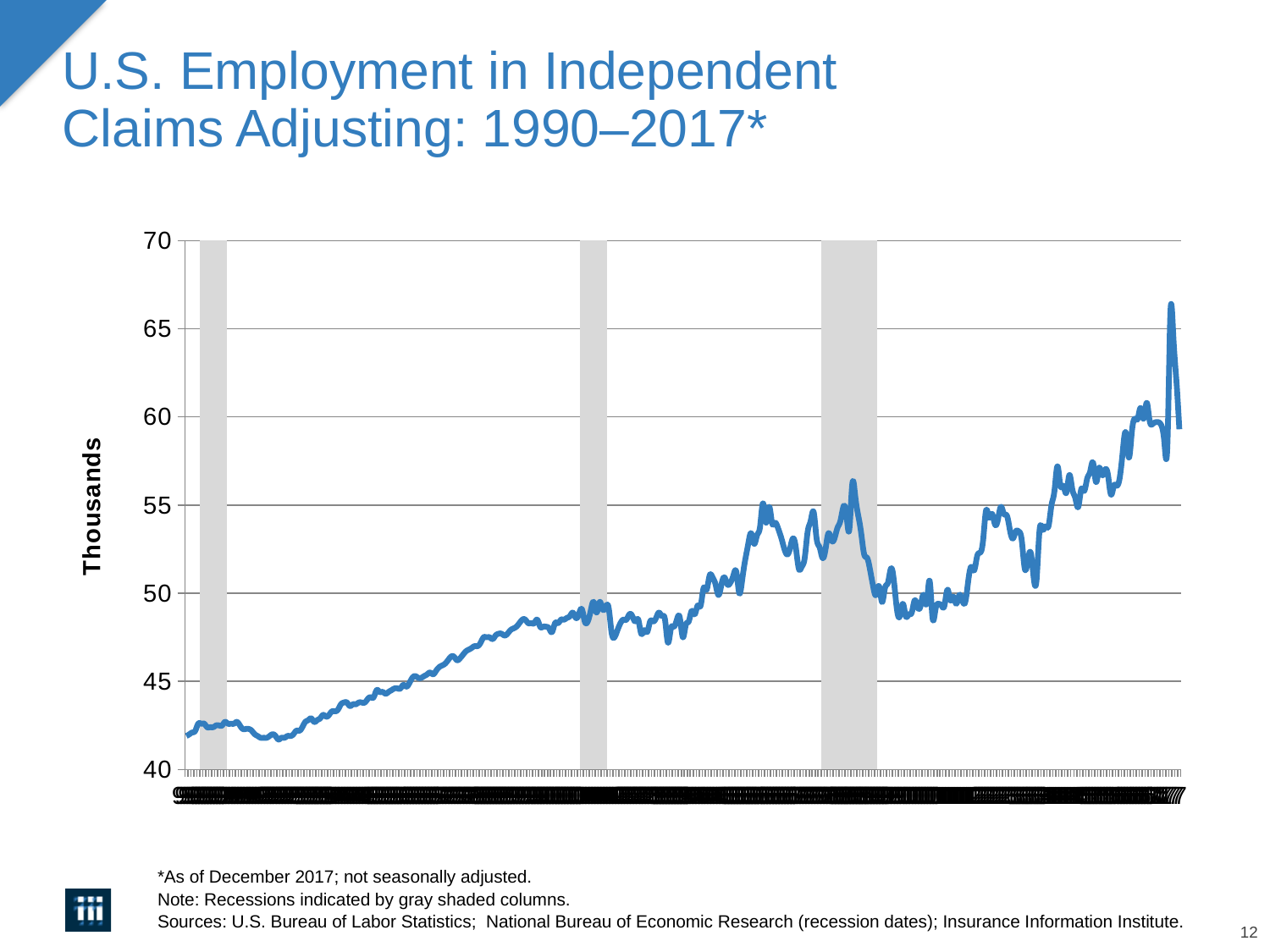
Is the highest point on the line greater or less than 70? less Is the final value of the series (far right) greater or less than 55? greater What is the label on the vertical axis? Thousands What kind of chart is shown on the slide? line chart How many gray shaded recession columns are shown on the chart? 3 Is the value at the start of the series greater or less than 40? greater Overall, do the values rise or fall from the left of the chart to the right? rise